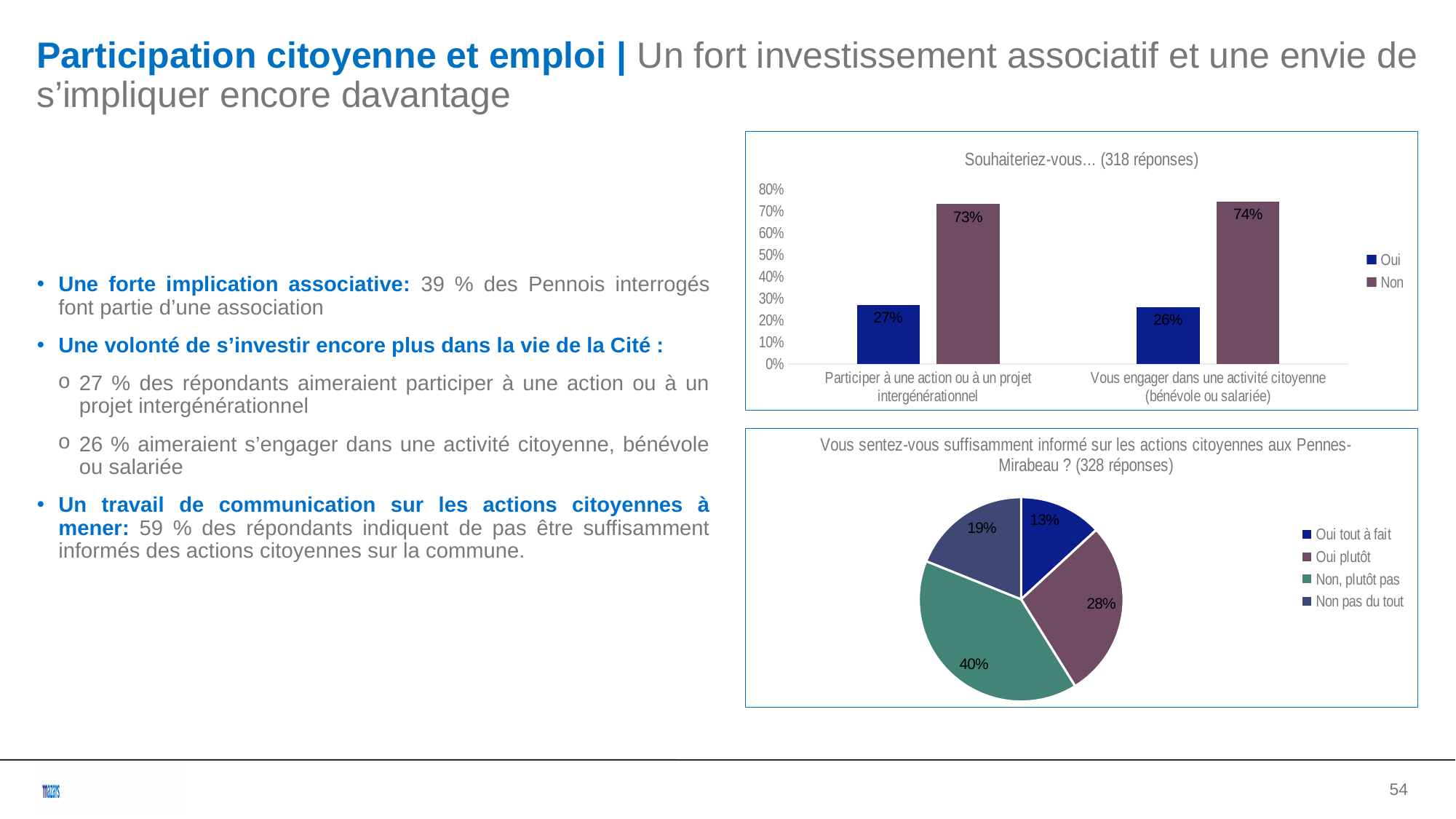
What kind of chart is the top-right chart titled 'Souhaiteriez-vous… (318 réponses)'? Bar chart In the 'Souhaiteriez-vous…' bar chart, how many categories are shown on the x axis? 2 In the 'Souhaiteriez-vous…' bar chart, what is the difference between the 'Non' and 'Oui' values for 'Participer à une action ou à un projet intergénérationnel'? 46% In the pie chart 'Vous sentez-vous suffisamment informé sur les actions citoyennes aux Pennes-Mirabeau ?', which response has the largest share? Non, plutôt pas In the pie chart 'Vous sentez-vous suffisamment informé sur les actions citoyennes aux Pennes-Mirabeau ?', what is the share for 'Non, plutôt pas'? 40% In the 'Souhaiteriez-vous…' bar chart, what is the 'Oui' value for 'Participer à une action ou à un projet intergénérationnel'? 27% In the pie chart 'Vous sentez-vous suffisamment informé sur les actions citoyennes aux Pennes-Mirabeau ?', which response has the smallest share? Oui tout à fait In the 'Souhaiteriez-vous…' bar chart, which is larger: the 'Oui' value for 'Participer à une action ou à un projet intergénérationnel' or the 'Oui' value for 'Vous engager dans une activité citoyenne (bénévole ou salariée)'? Participer à une action ou à un projet intergénérationnel In the 'Souhaiteriez-vous…' bar chart, how many series does the legend list? 2 In the 'Souhaiteriez-vous…' bar chart, what is the 'Non' value for 'Vous engager dans une activité citoyenne (bénévole ou salariée)'? 74% In the pie chart 'Vous sentez-vous suffisamment informé sur les actions citoyennes aux Pennes-Mirabeau ?', what is the difference between the 'Oui plutôt' and 'Non pas du tout' shares? 9% In the pie chart 'Vous sentez-vous suffisamment informé sur les actions citoyennes aux Pennes-Mirabeau ?', how many slices are there? 4